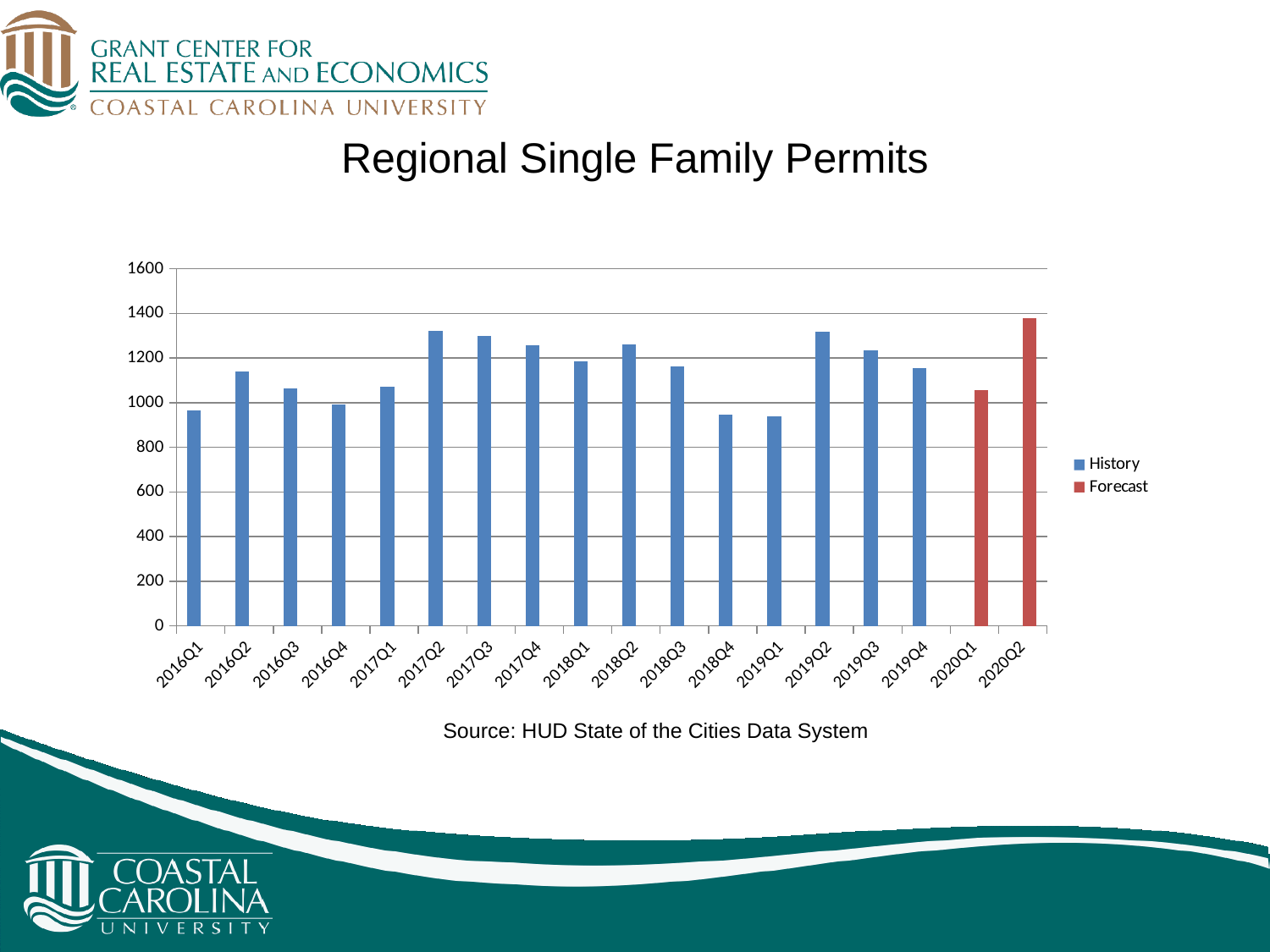
How many series does the legend list? 2 Is the value for 2020Q2 greater or less than 1200? greater How many quarters are shown on the x axis? 18 Which is larger, the value for 2018Q2 or the value for 2018Q4? 2018Q2 What type of chart is shown on the slide? Bar chart Is the value for 2017Q2 greater or less than 1200? greater Which quarters are shown as Forecast rather than History? 2020Q1 and 2020Q2 Is the value for 2016Q1 greater or less than 1000? less Do the values rise or fall from 2018Q2 to 2019Q1? fall Which quarter has the highest number of permits? 2020Q2 Which is larger, the value for 2020Q1 or the value for 2020Q2? 2020Q2